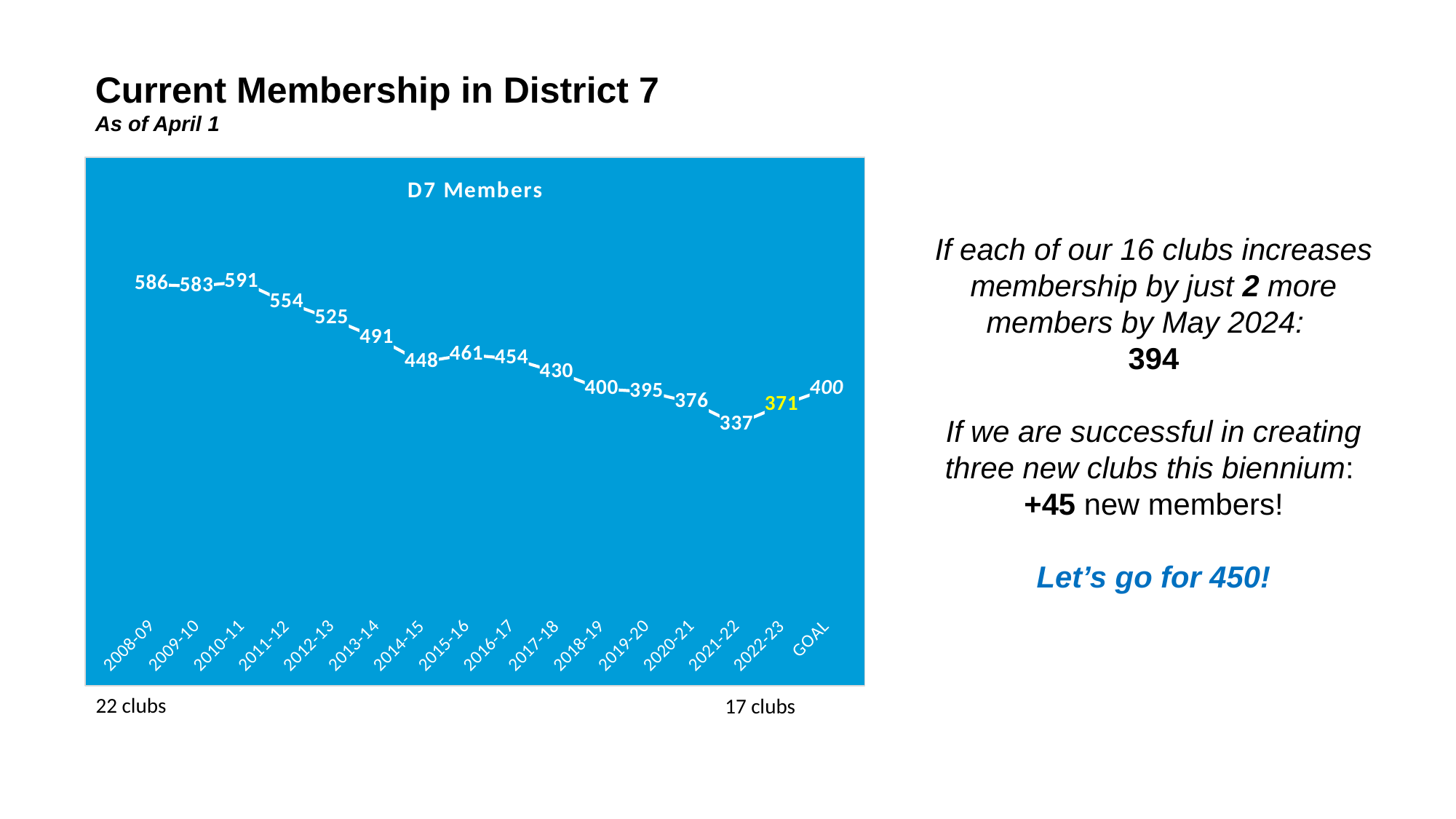
Does the membership generally rise or fall from 2010-11 to 2021-22? fall Which category has the highest value? 2010-11 Which is larger, the value for 2014-15 or the value for 2015-16? 2015-16 Which category has the lowest value? 2021-22 How many data points are plotted on the chart? 16 What is the value for 2022-23? 371 What is the value for 2008-09? 586 What is the difference between the values for 2008-09 and 2022-23? 215 What is the title of the chart? D7 Members What type of chart is shown on the slide? line chart What is the value for GOAL? 400 What is the value for 2021-22? 337